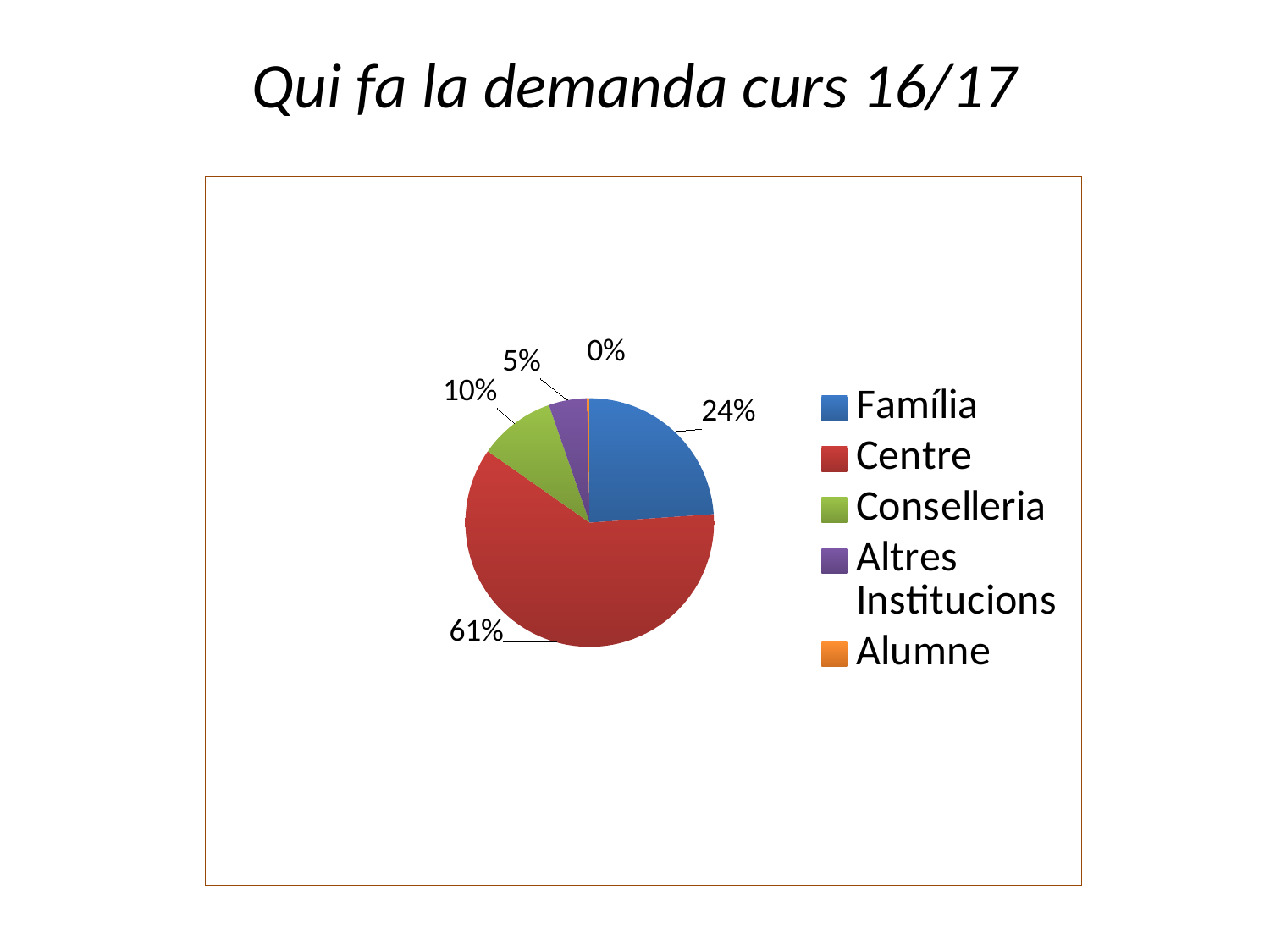
What share of the pie does Altres Institucions have? 5% What share of the pie does Alumne have? 0% What share of the pie does Centre have? 61% What is the difference in percentage points between Centre and Família? 37% Which category has the largest slice of the pie? Centre How many categories does the legend list? 5 Which category has the smallest slice of the pie? Alumne What is the title of the slide? Qui fa la demanda curs 16/17 What kind of chart is shown on the slide? pie chart Which is larger, the share for Conselleria or the share for Altres Institucions? Conselleria